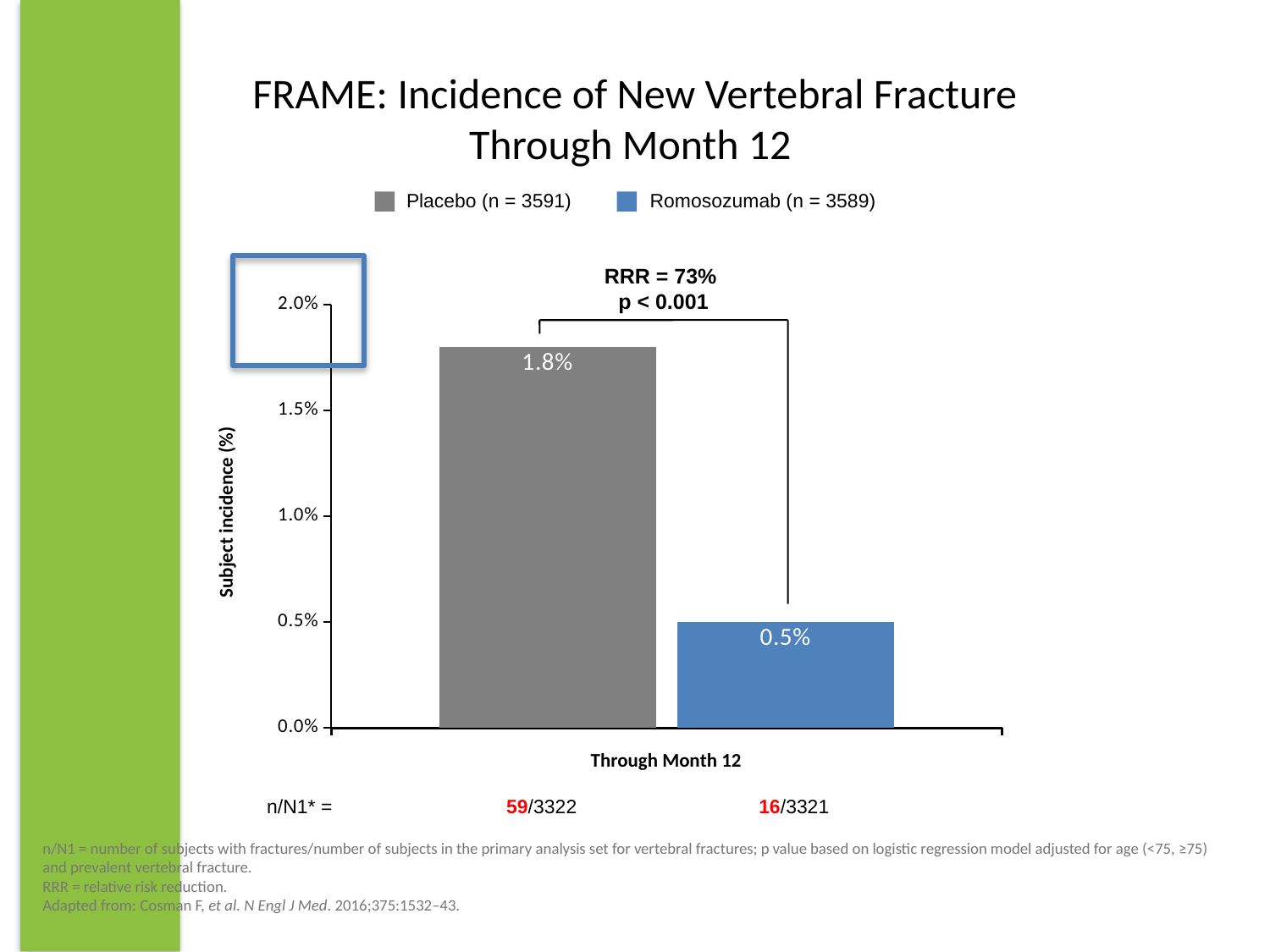
How many series does the legend list? 2 What is the relative risk reduction (RRR) shown on the chart? 73% What is the difference in subject incidence between Placebo and Romosozumab? 1.3% What is the subject incidence of new vertebral fracture for Romosozumab through Month 12? 0.5% Which treatment group has the lower incidence of new vertebral fracture? Romosozumab Is the incidence for Placebo greater or less than 1.5%? greater Which treatment group has the higher incidence of new vertebral fracture? Placebo What is the label on the y axis of the chart? Subject incidence (%) What kind of chart is shown on the slide? Bar chart What is the subject incidence of new vertebral fracture for Placebo through Month 12? 1.8% Is the incidence for Romosozumab greater or less than 1.0%? less What is the n/N1 value shown for the Romosozumab group? 16/3321